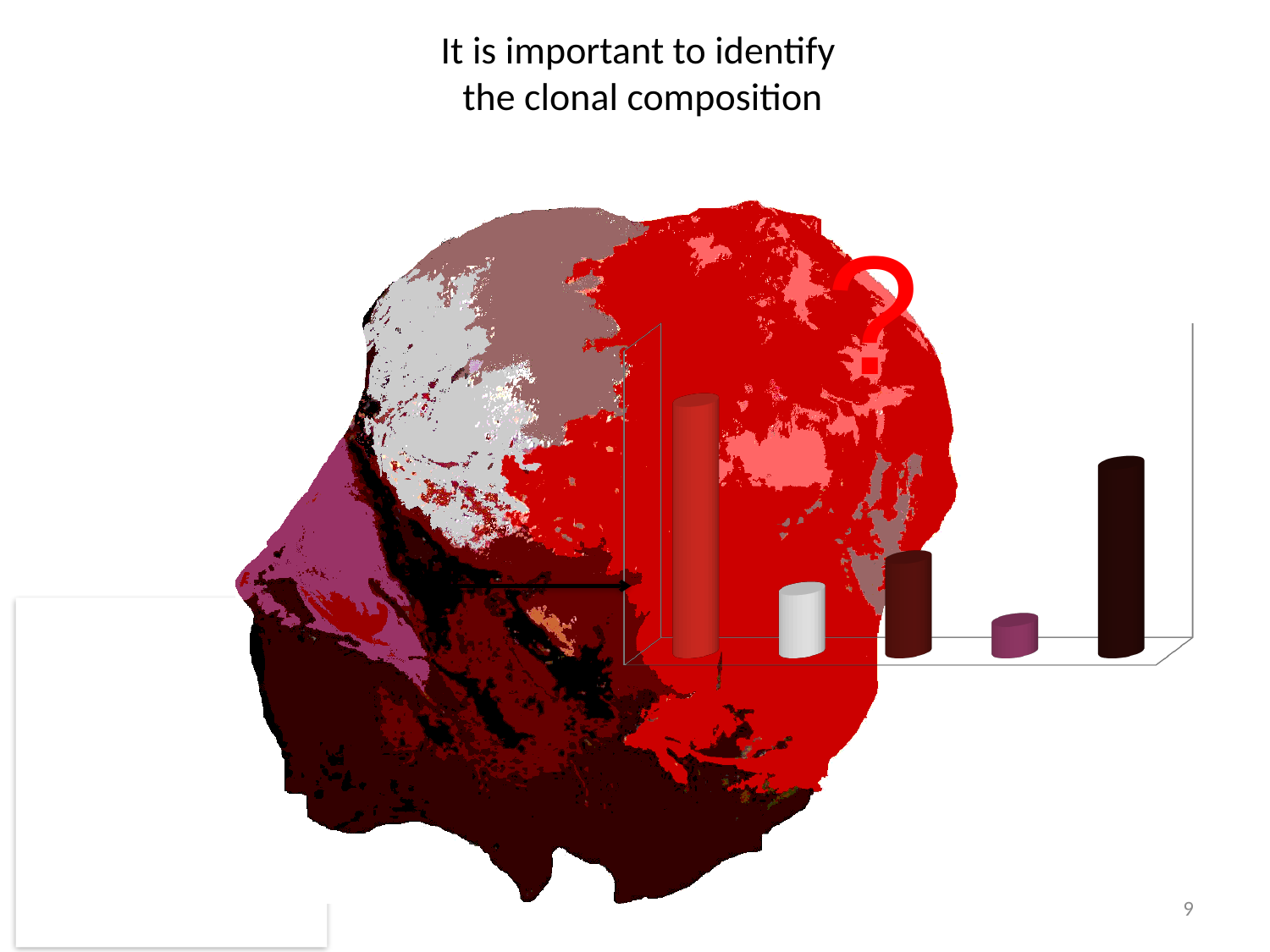
Does the chart on the slide display a legend? No Which bar in the chart is the tallest? the red bar (first from the left) Which bar in the chart is the shortest? the purple bar (fourth from the left) Which is taller in the chart, the dark bar on the far right or the white bar (second from the left)? the dark bar on the far right Which bar in the chart is the second tallest? the dark bar on the far right (fifth from the left) What colour is the tallest bar in the chart? red Which is taller in the chart, the red bar (first from the left) or the white bar (second from the left)? the red bar What kind of chart is shown on the slide? bar chart Which is taller in the chart, the dark red bar (third from the left) or the purple bar (fourth from the left)? the dark red bar How many bars does the chart on the slide contain? 5